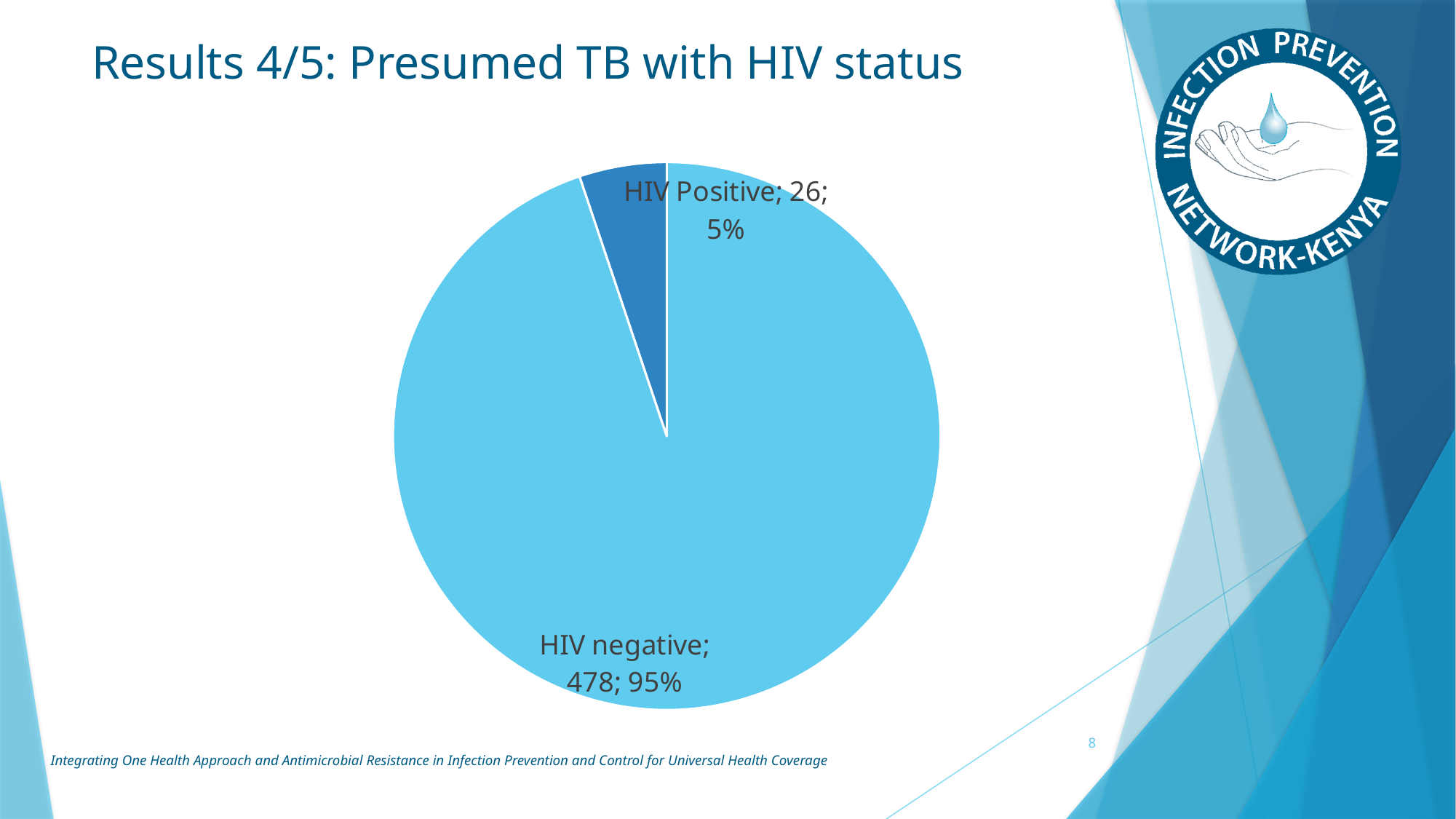
Which is larger, HIV Positive or HIV negative? HIV negative Which category has the largest slice? HIV negative What is the value for HIV negative? 478 What is the difference between the HIV negative and HIV Positive counts? 452 How many slices does the pie chart have? 2 Which category has the smallest slice? HIV Positive What is the total of the two slices in the pie chart? 504 What share of the pie does HIV Positive represent? 5% What is the value for HIV Positive? 26 What is the title of the slide containing the pie chart? Results 4/5: Presumed TB with HIV status What kind of chart is shown on the slide? pie chart What share of the pie does HIV negative represent? 95%